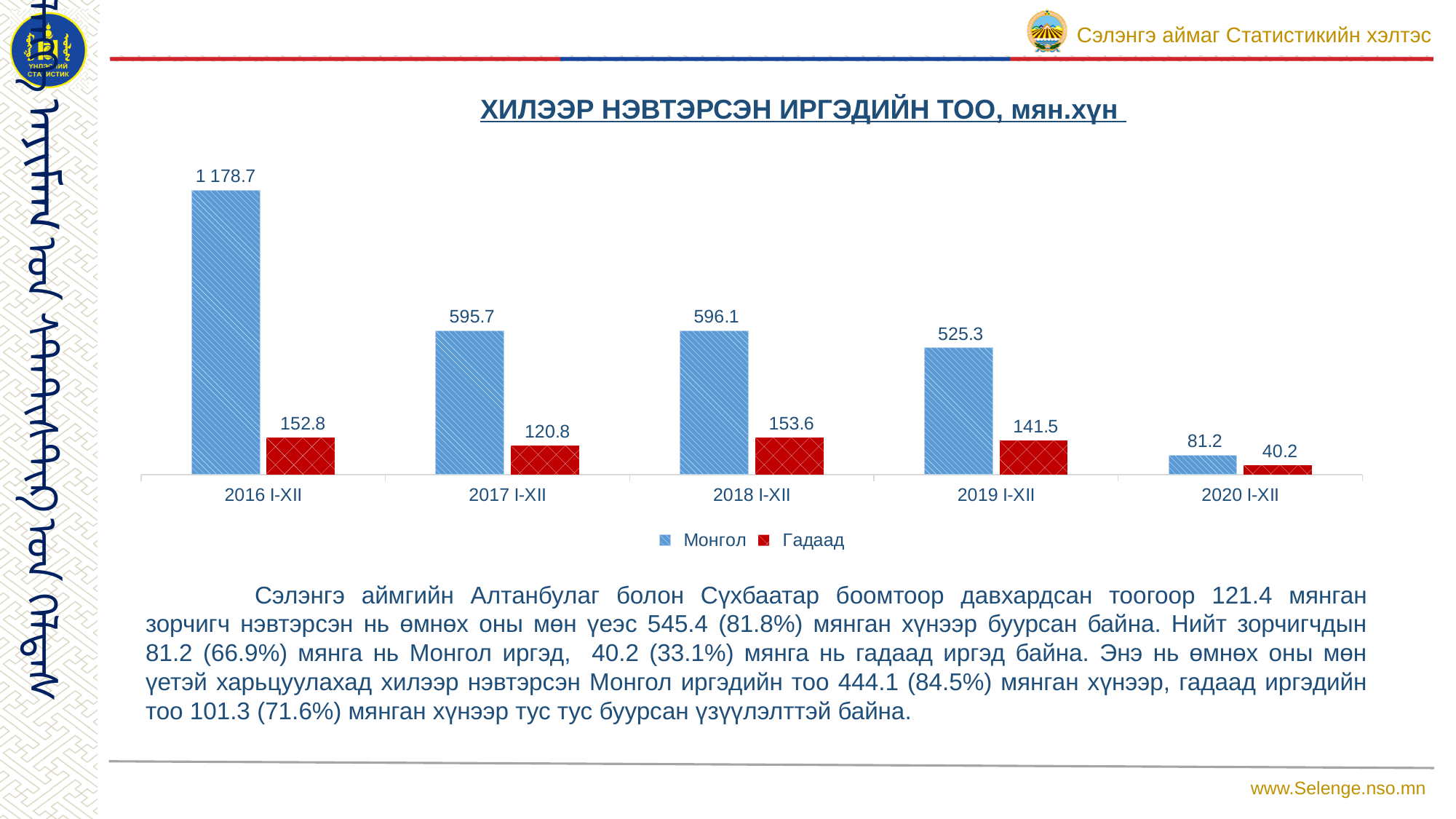
What is the difference between the Монгол values in 2019 I-XII and 2020 I-XII? 444.1 What is the difference between the Монгол and Гадаад values in 2020 I-XII? 41.0 What is the value for Монгол in 2020 I-XII? 81.2 What colour are the bars for the Гадаад series? Red What is the value for Монгол in 2016 I-XII? 1 178.7 What kind of chart is shown on the slide? Bar chart Which year has the highest value for Гадаад? 2018 I-XII How many series does the legend list? 2 What is the value for Гадаад in 2019 I-XII? 141.5 Which year has the lowest value for Монгол? 2020 I-XII How many years are shown on the x axis? 5 Which is larger, the Гадаад value in 2016 I-XII or in 2017 I-XII? 2016 I-XII